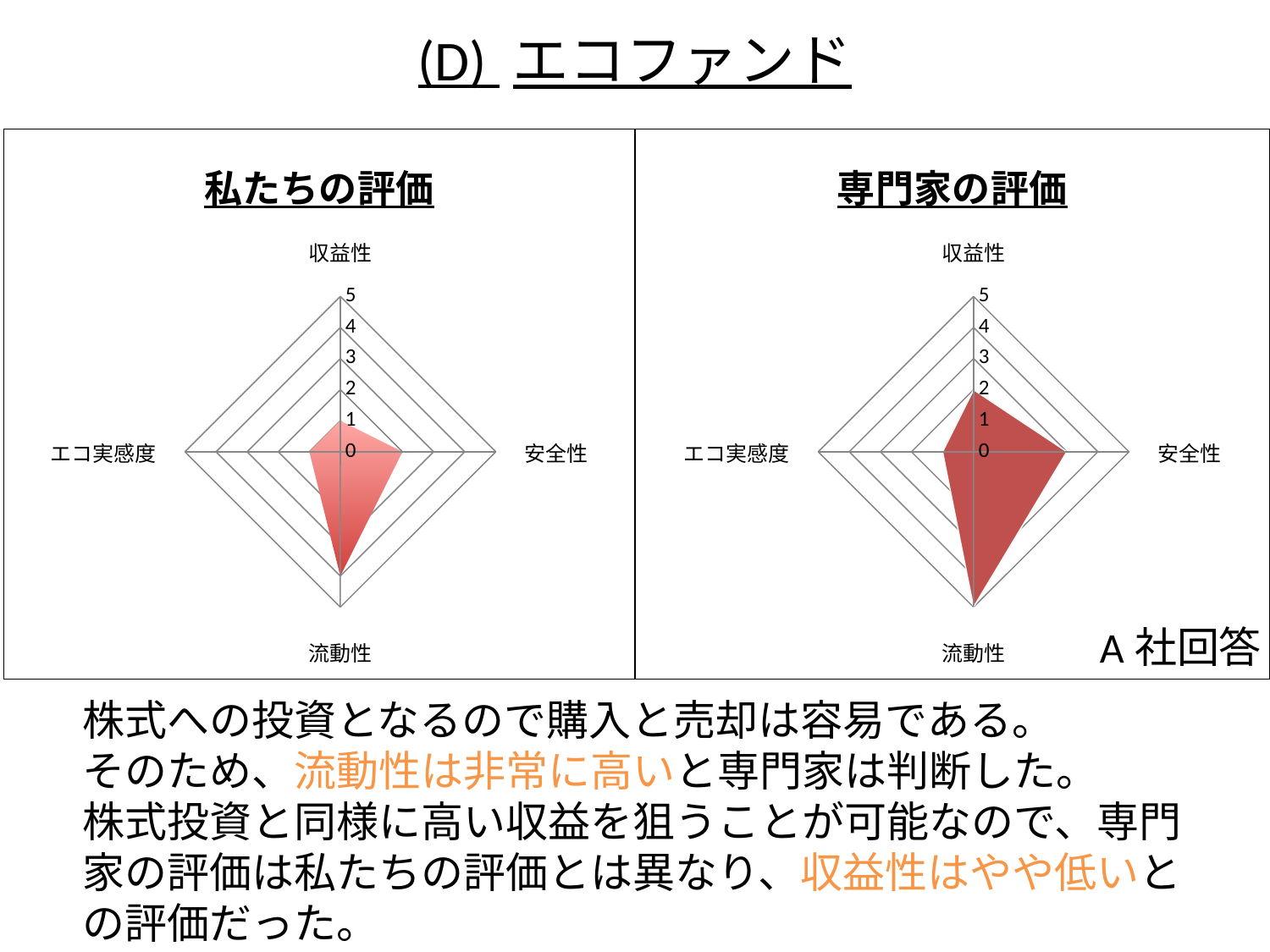
What is the maximum value shown on the axis scale of the radar charts? 5 In the 私たちの評価 chart, which category has the highest value? 流動性 In the 私たちの評価 chart, is the value for 収益性 greater or less than 2? less In the 私たちの評価 chart, is the value for 流動性 greater or less than 3? greater In the 専門家の評価 chart, which category has the highest value? 流動性 In the 専門家の評価 chart, which category has the lowest value? エコ実感度 How many axes (categories) does the 専門家の評価 radar chart have? 4 In the 専門家の評価 chart, what is the value for 流動性? 5 Which chart shows a larger value for 安全性, 私たちの評価 or 専門家の評価? 専門家の評価 In the 専門家の評価 chart, what is the value for 収益性? 2 In the 専門家の評価 chart, what is the value for 安全性? 3 What kind of chart is shown under 私たちの評価? radar chart